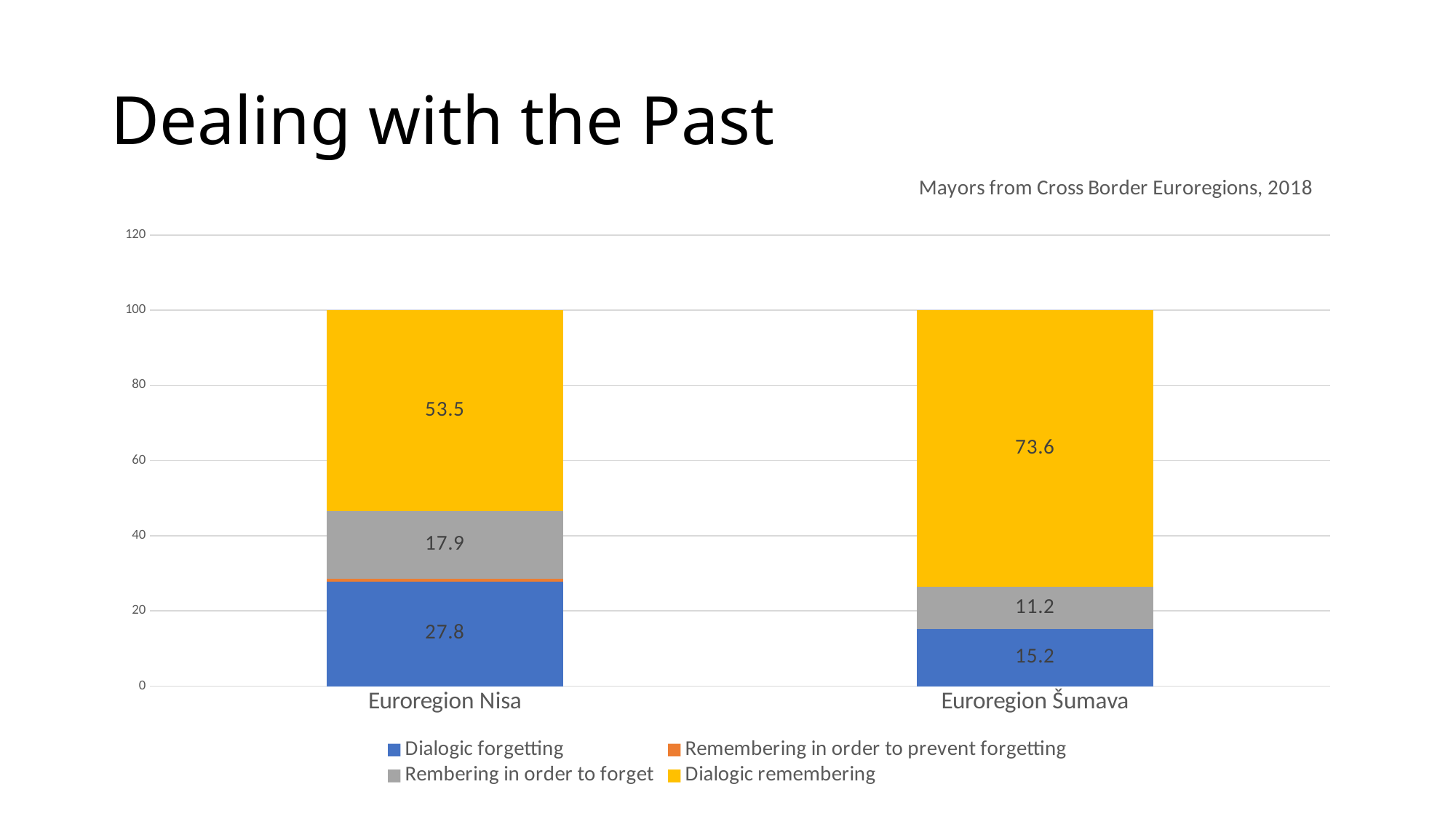
Which Euroregion has the lower value for Dialogic forgetting? Euroregion Šumava What is the value for Dialogic remembering in Euroregion Nisa? 53.5 Which Euroregion has the higher value for Dialogic remembering? Euroregion Šumava What kind of chart is shown on the slide? Stacked bar chart How many Euroregions are shown on the x axis? 2 What is the difference between the Dialogic forgetting values for Euroregion Nisa and Euroregion Šumava? 12.6 How many series does the legend list? 4 What is the difference between the Dialogic remembering values for Euroregion Šumava and Euroregion Nisa? 20.1 Is the Rembering in order to forget value larger for Euroregion Nisa or Euroregion Šumava? Euroregion Nisa What is the value for Dialogic remembering in Euroregion Šumava? 73.6 What is the value for Rembering in order to forget in Euroregion Šumava? 11.2 What is the value for Dialogic forgetting in Euroregion Nisa? 27.8